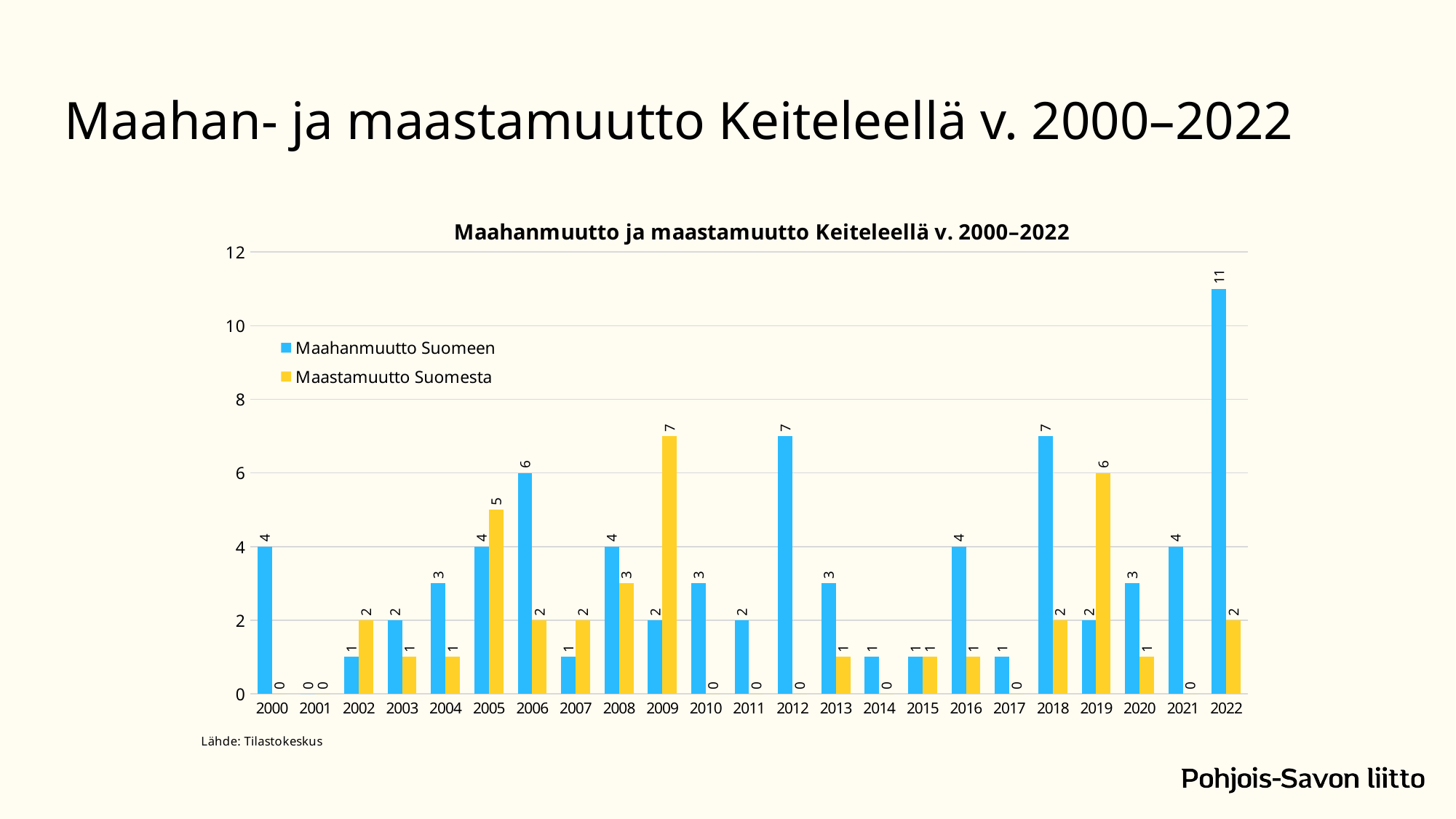
What is the title of the chart? Maahanmuutto ja maastamuutto Keiteleellä v. 2000–2022 What is the value of Maahanmuutto Suomeen in 2012? 7 What is the difference between Maahanmuutto Suomeen and Maastamuutto Suomesta in 2022? 9 How many years are shown on the x axis of the chart? 23 Which year has the highest value for Maastamuutto Suomesta? 2009 In 2019, which is larger: Maahanmuutto Suomeen or Maastamuutto Suomesta? Maastamuutto Suomesta What is the value of Maastamuutto Suomesta in 2009? 7 What is the value of Maahanmuutto Suomeen in 2022? 11 Which year has the highest value for Maahanmuutto Suomeen? 2022 How many series does the legend list? 2 In 2006, which is larger: Maahanmuutto Suomeen or Maastamuutto Suomesta? Maahanmuutto Suomeen What kind of chart is shown on the slide? Bar chart